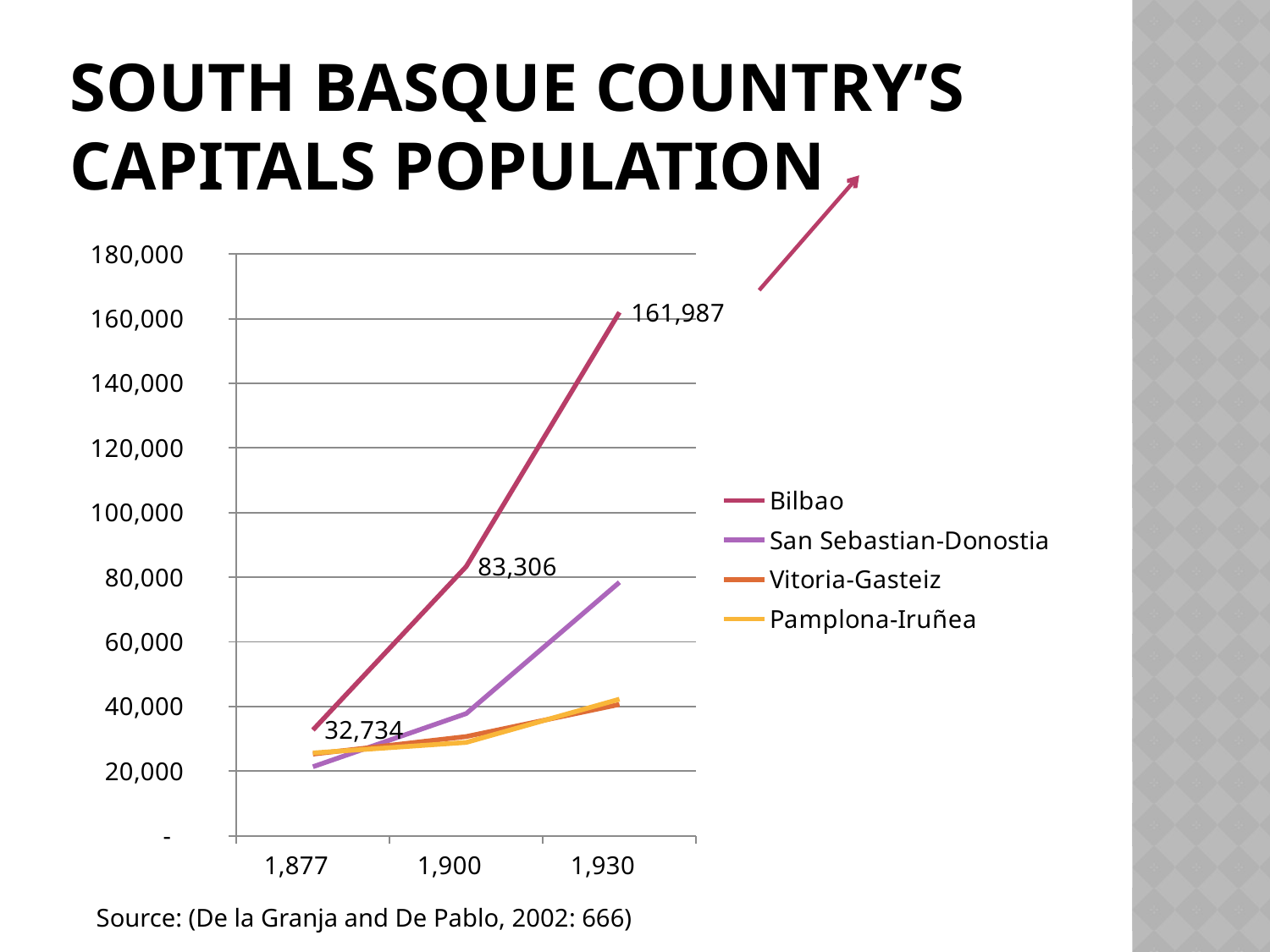
How many series does the legend list? 4 What is the population of Bilbao in 1,900? 83,306 Is the population of Pamplona-Iruñea in 1,930 greater or less than 60,000? less Which city has the lowest population in 1,877? San Sebastian-Donostia What kind of chart is shown on the slide? line chart What is the difference between Bilbao's population in 1,900 and in 1,877? 50,572 By how much did Bilbao's population grow between 1,877 and 1,930? 129,253 What is the population of Bilbao in 1,877? 32,734 What is the population of Bilbao in 1,930? 161,987 Does the population of Bilbao rise or fall from 1,877 to 1,930? rises Is the population of San Sebastian-Donostia in 1,930 greater or less than 60,000? greater Which city has the highest population in 1,930? Bilbao